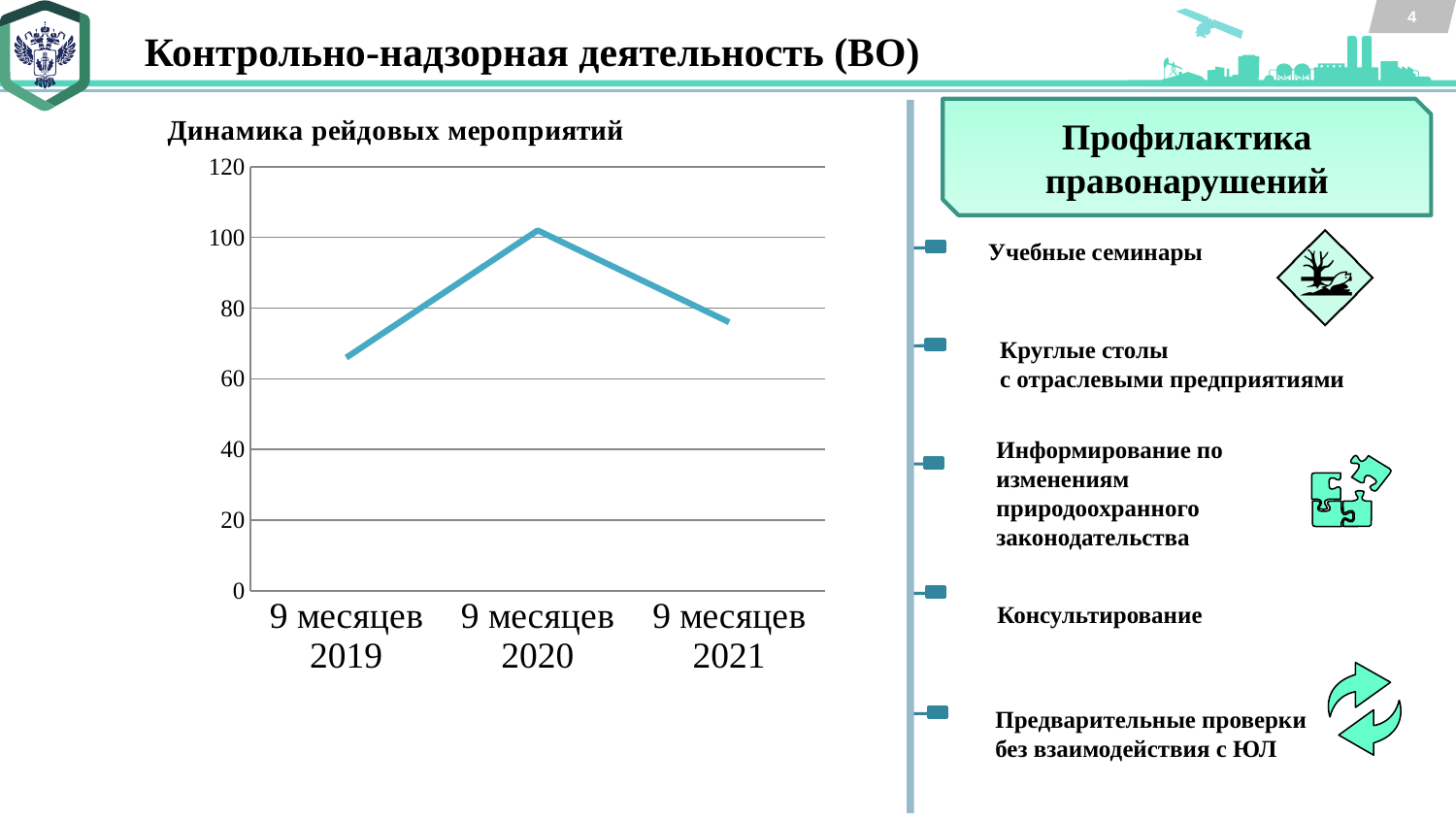
What is the title of the chart on the left side of the slide? Динамика рейдовых мероприятий On the "Динамика рейдовых мероприятий" chart, which is larger: the value for 9 месяцев 2019 or for 9 месяцев 2021? 9 месяцев 2021 Is the value for 9 месяцев 2019 on the "Динамика рейдовых мероприятий" chart greater or less than 80? less On the "Динамика рейдовых мероприятий" chart, does the value rise or fall from 9 месяцев 2019 to 9 месяцев 2020? rise What kind of chart is shown under the title "Динамика рейдовых мероприятий"? line chart How many data points are plotted on the "Динамика рейдовых мероприятий" chart? 3 Is the value for 9 месяцев 2021 on the "Динамика рейдовых мероприятий" chart greater or less than 60? greater On the "Динамика рейдовых мероприятий" chart, does the value rise or fall from 9 месяцев 2020 to 9 месяцев 2021? fall Which period has the lowest value on the "Динамика рейдовых мероприятий" chart? 9 месяцев 2019 Which period has the highest value on the "Динамика рейдовых мероприятий" chart? 9 месяцев 2020 On the "Динамика рейдовых мероприятий" chart, which is larger: the value for 9 месяцев 2020 or for 9 месяцев 2021? 9 месяцев 2020